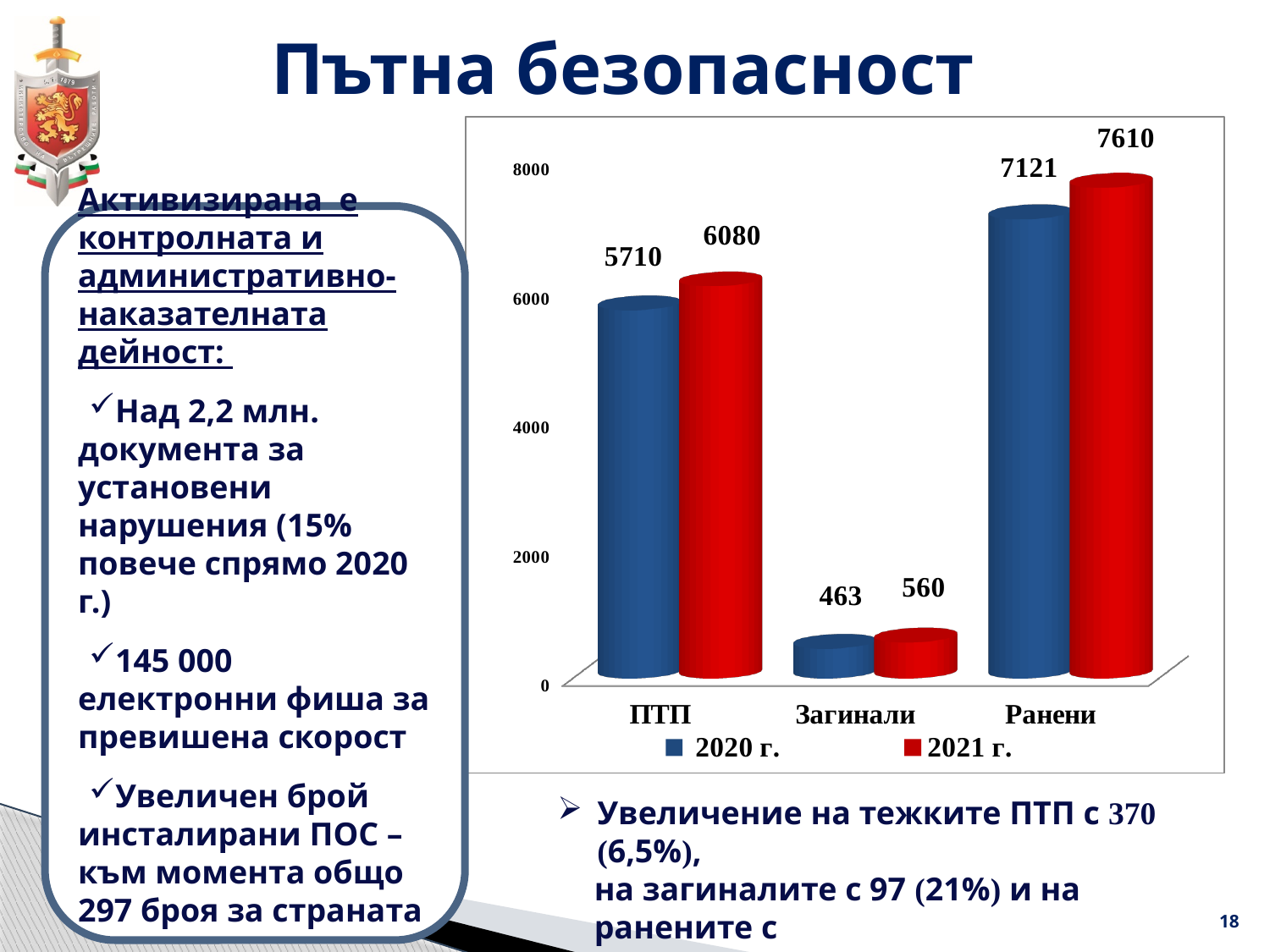
How many series does the legend list? 2 Which colour represents the 2021 г. series? red What is the value for ПТП in 2020 г.? 5710 What is the difference between the 2021 г. and 2020 г. values for Загинали? 97 What is the value for Ранени in 2021 г.? 7610 What is the value for Загинали in 2020 г.? 463 Which category has the lowest value in 2020 г.? Загинали What kind of chart is shown on the slide? bar chart How many categories are shown on the x axis? 3 Which is larger, the 2020 г. value for Ранени or the 2021 г. value for ПТП? 2020 г. value for Ранени Which category has the highest value in 2021 г.? Ранени What is the difference between the 2021 г. and 2020 г. values for ПТП? 370